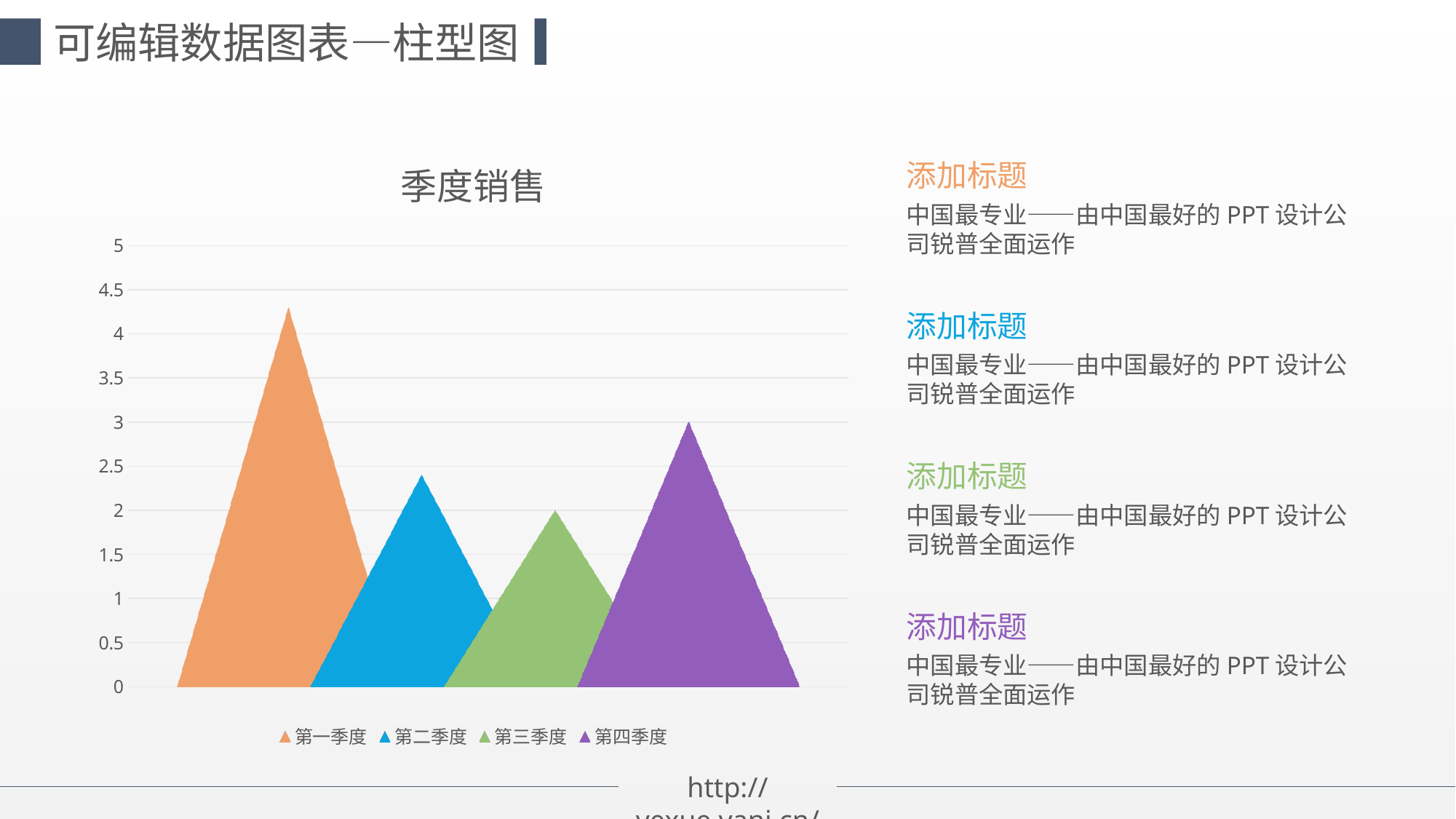
What is the value for 第四季度? 3 What is the title of the chart? 季度销售 Is the value for 第一季度 greater or less than 4? greater Is the value for 第二季度 greater or less than 3? less Which is larger, the value for 第一季度 or the value for 第三季度? 第一季度 Which series has the highest value? 第一季度 Which is larger, the value for 第二季度 or the value for 第四季度? 第四季度 How many series does the legend list? 4 What kind of chart is shown on the slide? bar chart What colour is the bar for 第四季度? purple Which series has the lowest value? 第三季度 How many bars are plotted in the chart? 4